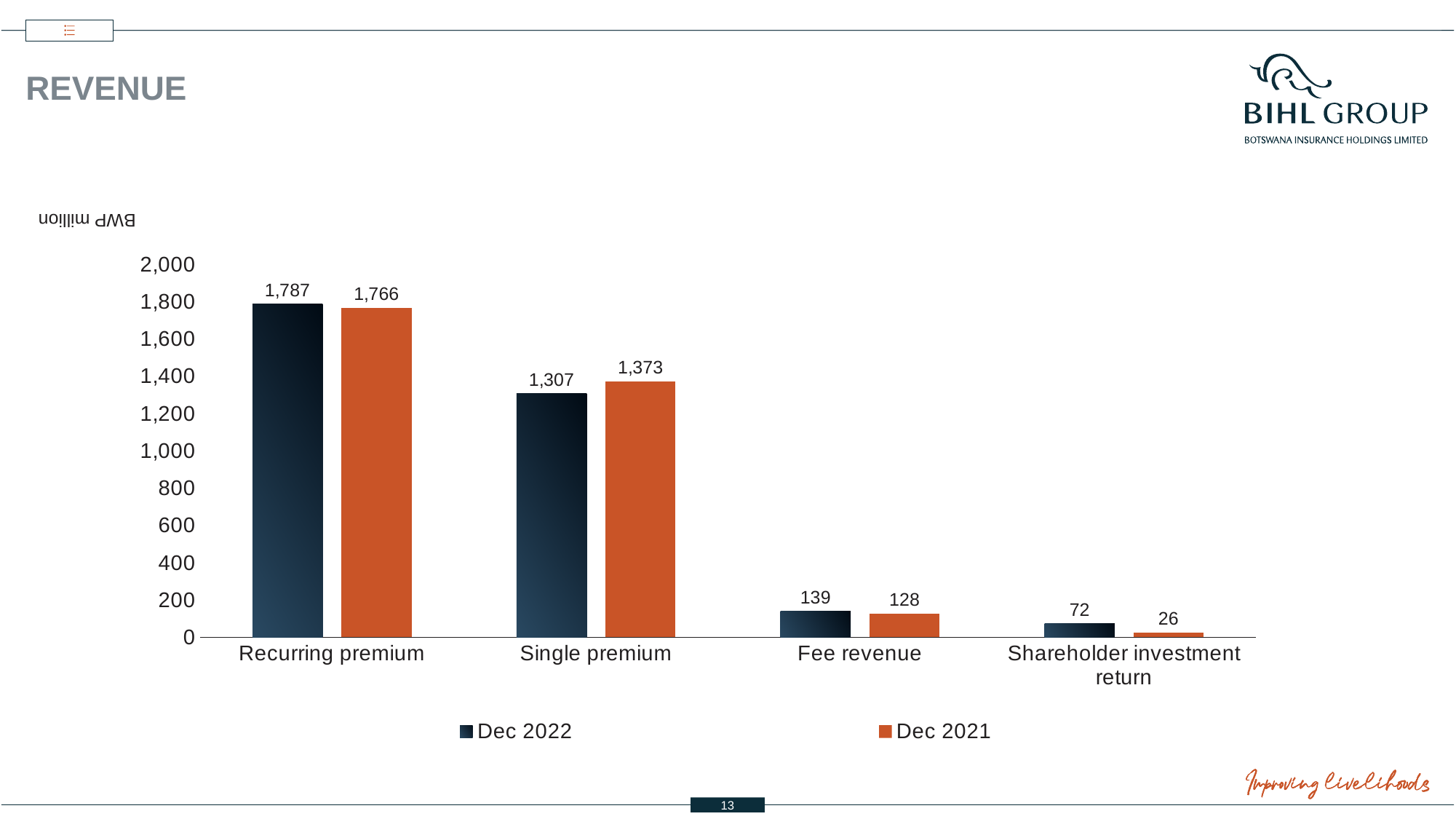
What is the difference between the Dec 2022 and Dec 2021 values for Shareholder investment return? 46 Which is larger for Fee revenue, the Dec 2022 value or the Dec 2021 value? Dec 2022 Which category has the lowest Dec 2021 value? Shareholder investment return How many categories are shown on the x axis? 4 What is the difference between the Dec 2022 and Dec 2021 values for Single premium? 66 How many series does the legend list? 2 What is the Dec 2021 value for Single premium? 1,373 What is the Dec 2022 value for Fee revenue? 139 What is the Dec 2022 value for Recurring premium? 1,787 What kind of chart is shown on the slide? Bar chart Which category has the highest Dec 2022 value? Recurring premium What is the Dec 2021 value for Shareholder investment return? 26